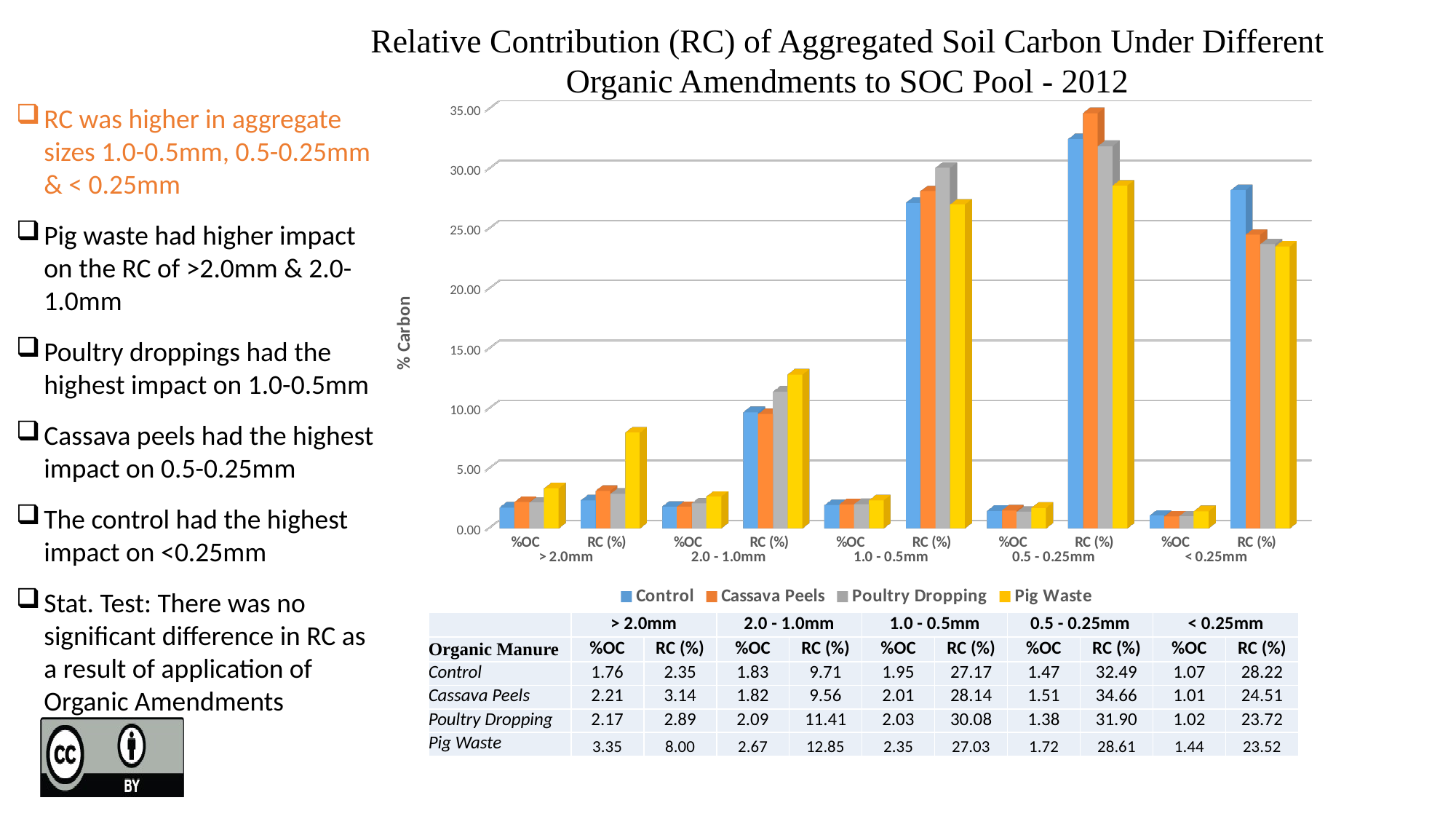
What is the %OC value for Poultry Dropping in the 2.0 - 1.0mm aggregate size? 2.09 Which bar is the tallest in the whole chart? Cassava Peels, RC (%) for 0.5 - 0.25mm What is the RC (%) value for Pig Waste in the > 2.0mm aggregate size? 8.00 Which is larger in the < 0.25mm aggregate size: the RC (%) of Control or of Cassava Peels? Control Is the RC (%) value for Cassava Peels in the 0.5 - 0.25mm aggregate size greater or less than 30.00? greater What is the RC (%) value for Cassava Peels in the 0.5 - 0.25mm aggregate size? 34.66 Which organic amendment has the highest RC (%) in the 1.0 - 0.5mm aggregate size? Poultry Dropping What kind of chart is shown on the slide? bar chart What is the difference between the RC (%) of Pig Waste and Control in the 2.0 - 1.0mm aggregate size? 3.14 What is the title of the vertical axis of the chart? % Carbon Which organic amendment has the lowest RC (%) in the 0.5 - 0.25mm aggregate size? Pig Waste How many series does the legend list? 4